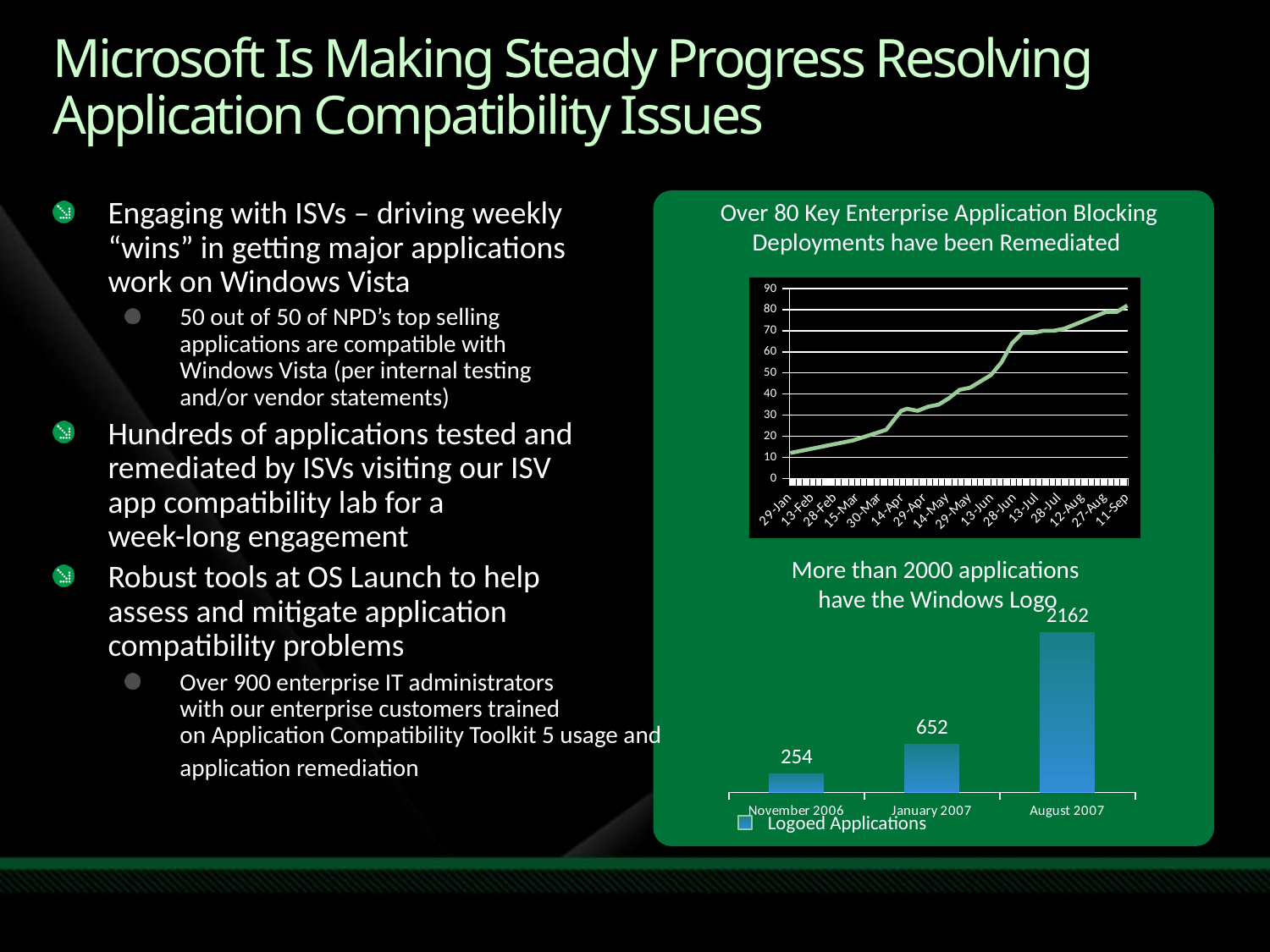
In the line chart titled "Over 80 Key Enterprise Application Blocking Deployments have been Remediated", is the value at 29-Jan greater or less than 20? less In the line chart titled "Over 80 Key Enterprise Application Blocking Deployments have been Remediated", do the values rise or fall from 29-Jan to 11-Sep? rise In the bar chart titled "More than 2000 applications have the Windows Logo", how many categories are shown? 3 In the bar chart titled "More than 2000 applications have the Windows Logo", what is the value for August 2007? 2162 What kind of chart is the top-right chart titled "Over 80 Key Enterprise Application Blocking Deployments have been Remediated"? line chart In the bar chart titled "More than 2000 applications have the Windows Logo", what series name does the legend show? Logoed Applications In the bar chart titled "More than 2000 applications have the Windows Logo", which category has the lowest value? November 2006 In the bar chart titled "More than 2000 applications have the Windows Logo", which category has the highest value? August 2007 In the bar chart titled "More than 2000 applications have the Windows Logo", what is the value for January 2007? 652 In the bar chart titled "More than 2000 applications have the Windows Logo", what is the value for November 2006? 254 In the bar chart titled "More than 2000 applications have the Windows Logo", what is the difference between the August 2007 and January 2007 values? 1510 What kind of chart is the bottom-right chart titled "More than 2000 applications have the Windows Logo"? bar chart